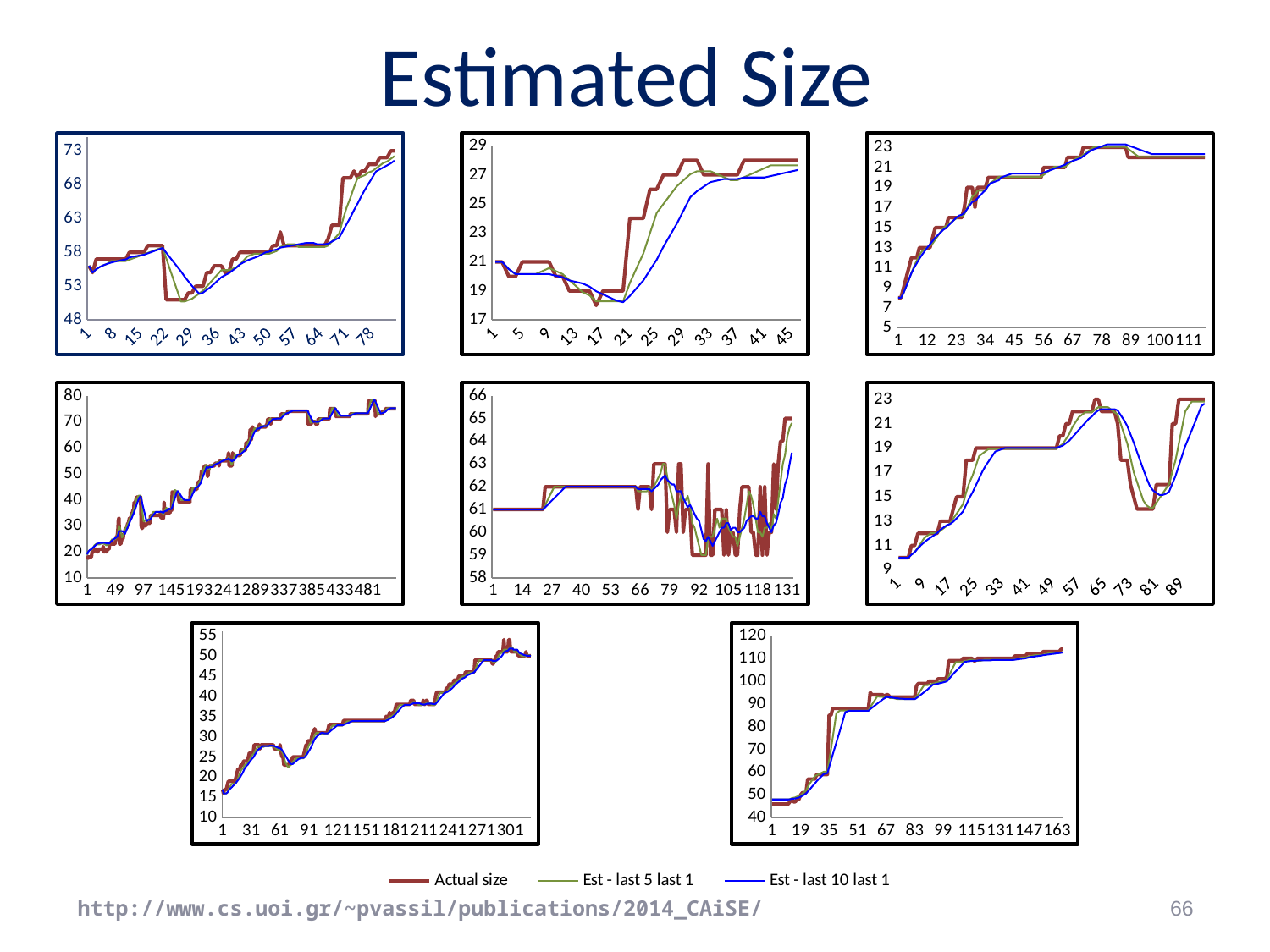
In the bottom-right chart (y axis 40 to 120), is the Actual size value at x = 163 greater or less than 100? greater In the top-left chart (y axis 48 to 73), is the Actual size value at the right end of the x axis greater or less than 68? greater In the bottom-left chart (y axis 10 to 55), do the values generally rise or fall along the x axis? rise In the top-right chart (y axis 5 to 23), do the values generally rise or fall along the x axis? rise How many series does the shared legend at the bottom of the slide list? 3 In the legend, which series is drawn in red? Actual size In the middle-left chart (y axis 10 to 80), is the Actual size value at x = 1 greater or less than 30? less In the top-middle chart (y axis 17 to 29), at x = 21 which series has the larger value, Actual size or Est - last 10 last 1? Actual size How many charts are shown on the slide? 8 In the legend, which series is drawn in blue? Est - last 10 last 1 What kind of chart is used in each of the panels on the slide? line chart